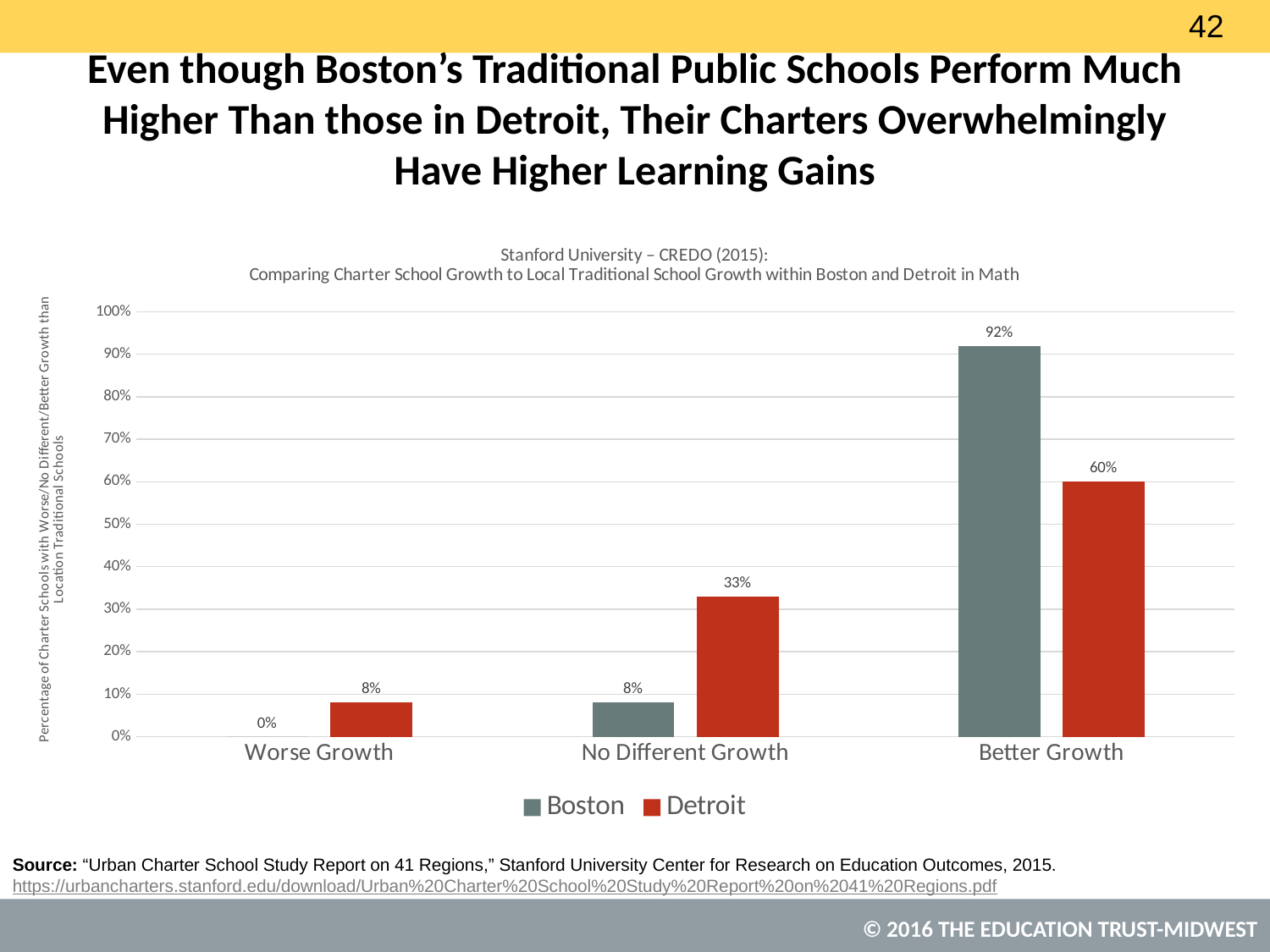
What is the value for Detroit in the No Different Growth category? 33% What is the difference between the Boston and Detroit values in the Better Growth category? 32% In the No Different Growth category, which is larger, Boston or Detroit? Detroit How many series does the legend list? 2 What is the value for Boston in the Better Growth category? 92% Which colour represents Detroit in the chart? Red What is the value for Detroit in the Better Growth category? 60% What is the value for Boston in the Worse Growth category? 0% Which category has the lowest value for Boston? Worse Growth How many categories are shown on the x axis? 3 What kind of chart is shown on the slide? Bar chart Which category has the highest value for Detroit? Better Growth